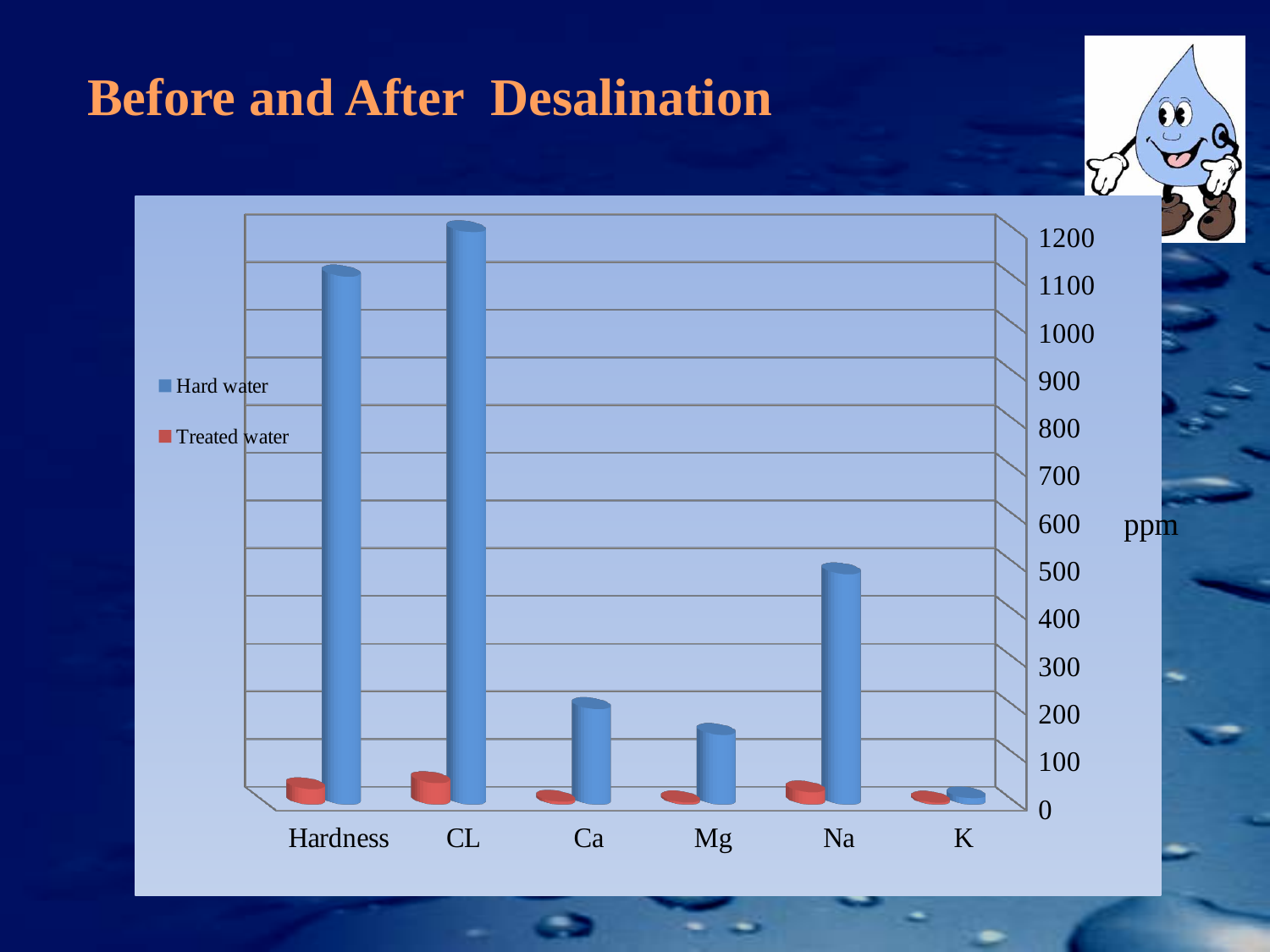
How many categories are shown on the x axis of the chart? 6 What unit is shown next to the value axis of the chart? ppm How many series does the chart's legend list? 2 Is the Hard water value for Mg greater or less than 200? less Which category has the highest Hard water value? CL Which category has the lowest Hard water value? K Is the Hard water value for Ca greater or less than 300? less Which is larger, the Hard water value for Hardness or the Hard water value for Na? Hardness Is the Hard water value for Na greater or less than 600? less What kind of chart is shown on the slide? bar chart